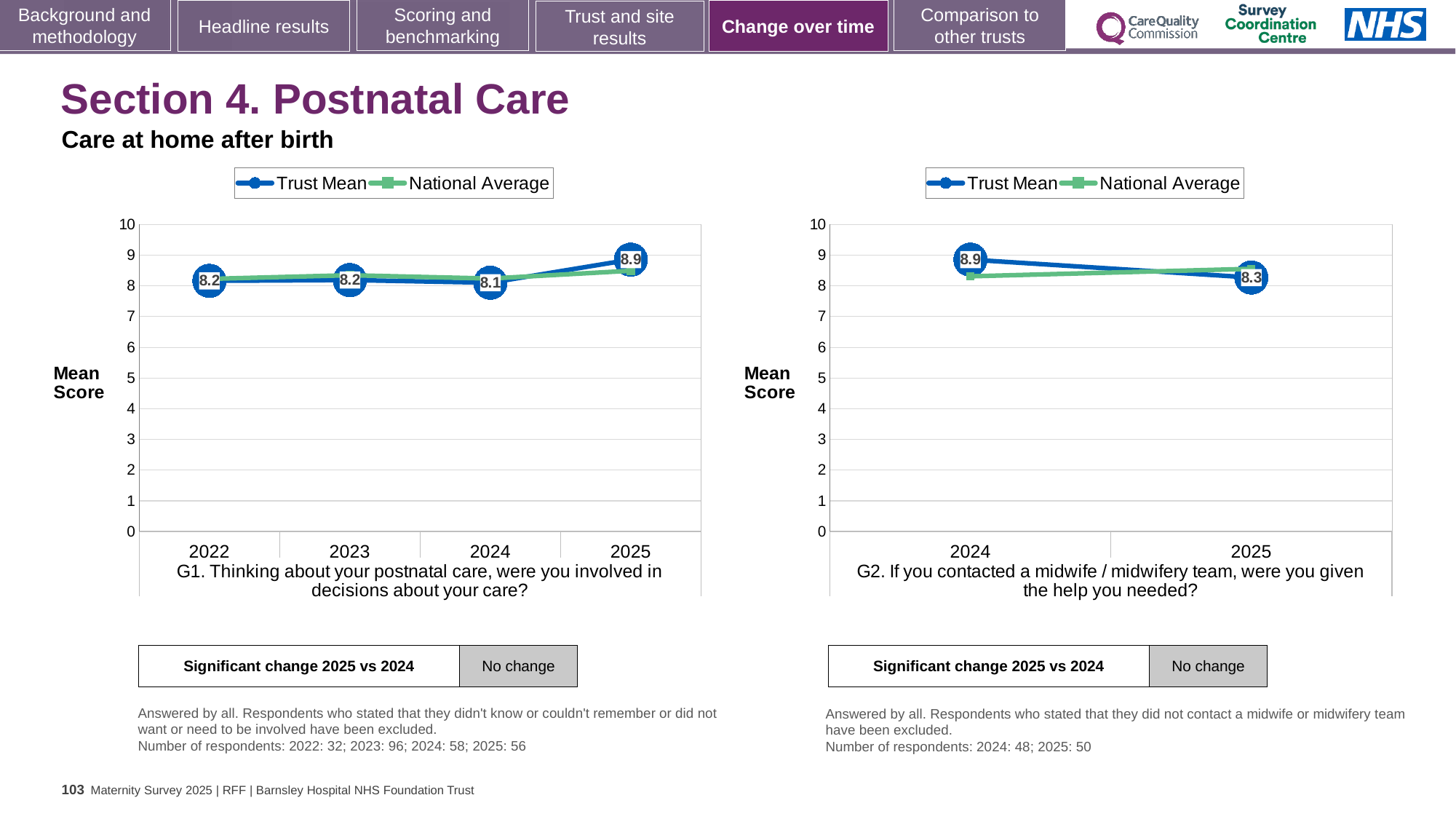
In the G2 chart on the right, is the Trust Mean score higher in 2024 or 2025? 2024 How many series does the legend of the G2 chart on the right list? 2 In the G2 chart on the right, what is the difference between the Trust Mean scores for 2024 and 2025? 0.6 In the G1 chart on the left, which year has the highest Trust Mean score? 2025 In the G1 chart on the left, which year has the lowest Trust Mean score? 2024 In the G2 chart on the right, does the Trust Mean rise or fall from 2024 to 2025? fall In the G2 chart on the right, what is the Trust Mean score for 2024? 8.9 In the G1 chart on the left, is the National Average for 2025 greater or less than 8? greater In the G1 chart on the left, what is the Trust Mean score for 2024? 8.1 In the G1 chart on the left, what is the difference between the Trust Mean scores for 2025 and 2024? 0.8 How many years are shown on the x axis of the G1 chart on the left? 4 In the G1 chart on the left, what is the Trust Mean score for 2025? 8.9